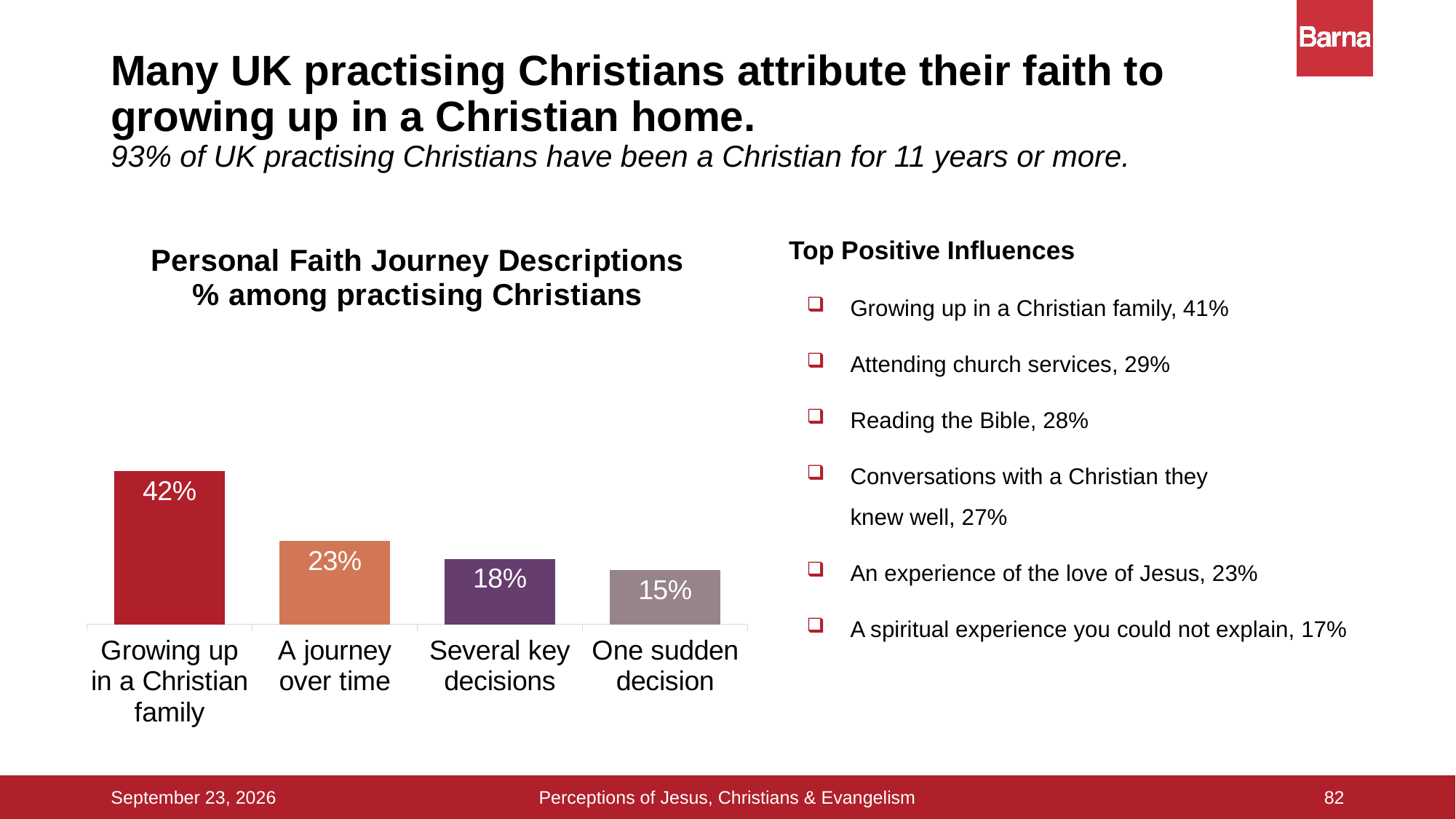
What is the value for 'A journey over time'? 23% Which faith journey description has the highest percentage? Growing up in a Christian family What is the title of the chart? Personal Faith Journey Descriptions % among practising Christians Which faith journey description has the lowest percentage? One sudden decision What type of chart is shown on the slide? Bar chart Do the values rise or fall from left to right across the categories? Fall Which is larger: the value for 'Several key decisions' or 'One sudden decision'? Several key decisions What is the value for 'Several key decisions'? 18% How many categories are shown in the bar chart? 4 What is the difference in percentage points between 'Growing up in a Christian family' and 'A journey over time'? 19 What is the value for 'One sudden decision'? 15% What percentage of practising Christians describe their faith journey as growing up in a Christian family? 42%